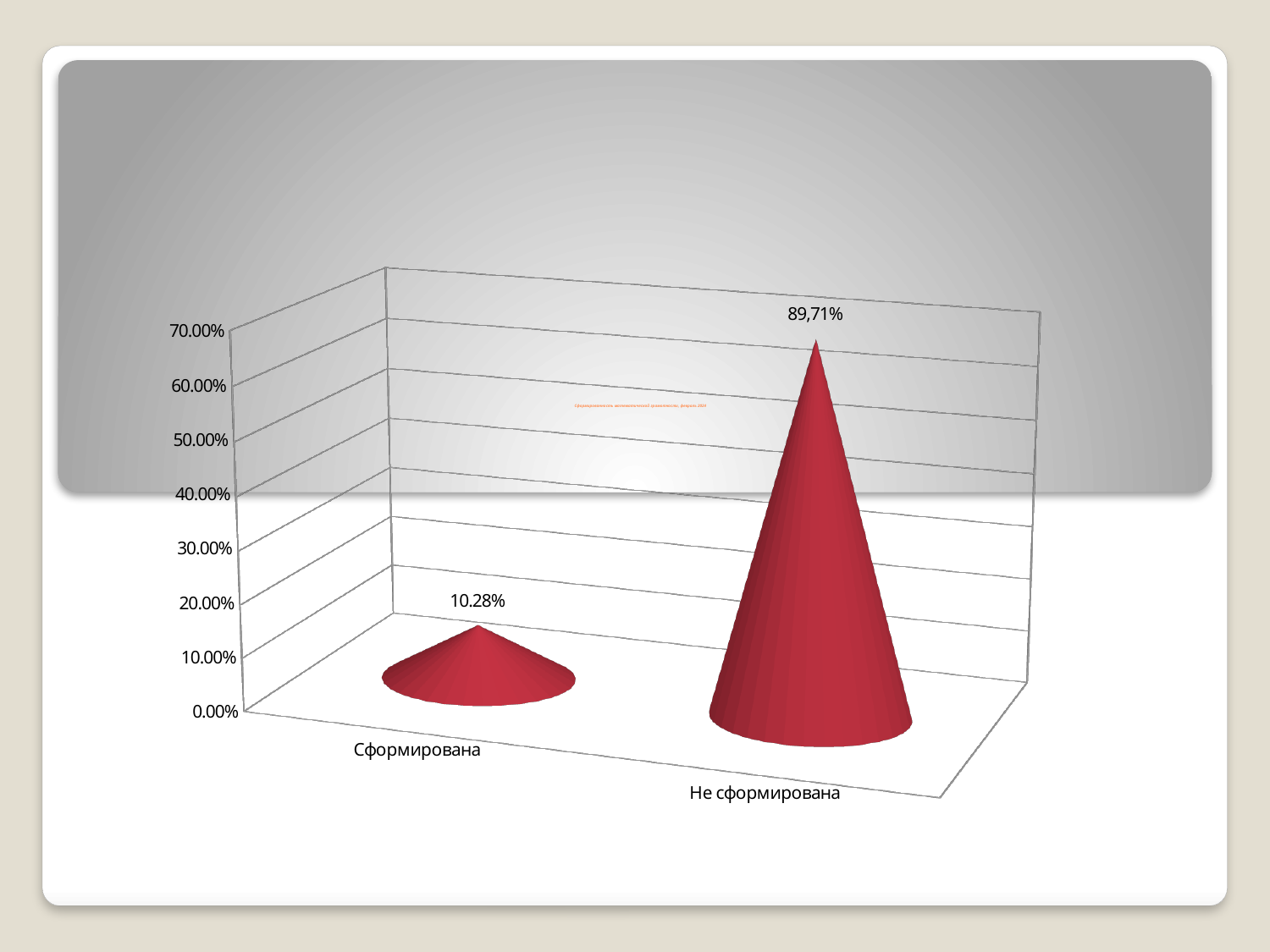
Which category has the highest value? Не сформирована What is the highest value labelled on the vertical axis? 70.00% Which is larger, the value for "Сформирована" or the value for "Не сформирована"? Не сформирована Is the value for "Сформирована" greater or less than 20.00%? less What is the value shown for the category "Сформирована"? 10.28% How many categories are shown on the chart? 2 Which category has the lowest value? Сформирована Do the values rise or fall from the left category to the right category? rise Is the value for "Не сформирована" greater or less than 50.00%? greater What kind of chart is shown on the slide? bar chart What is the value shown for the category "Не сформирована"? 89,71%